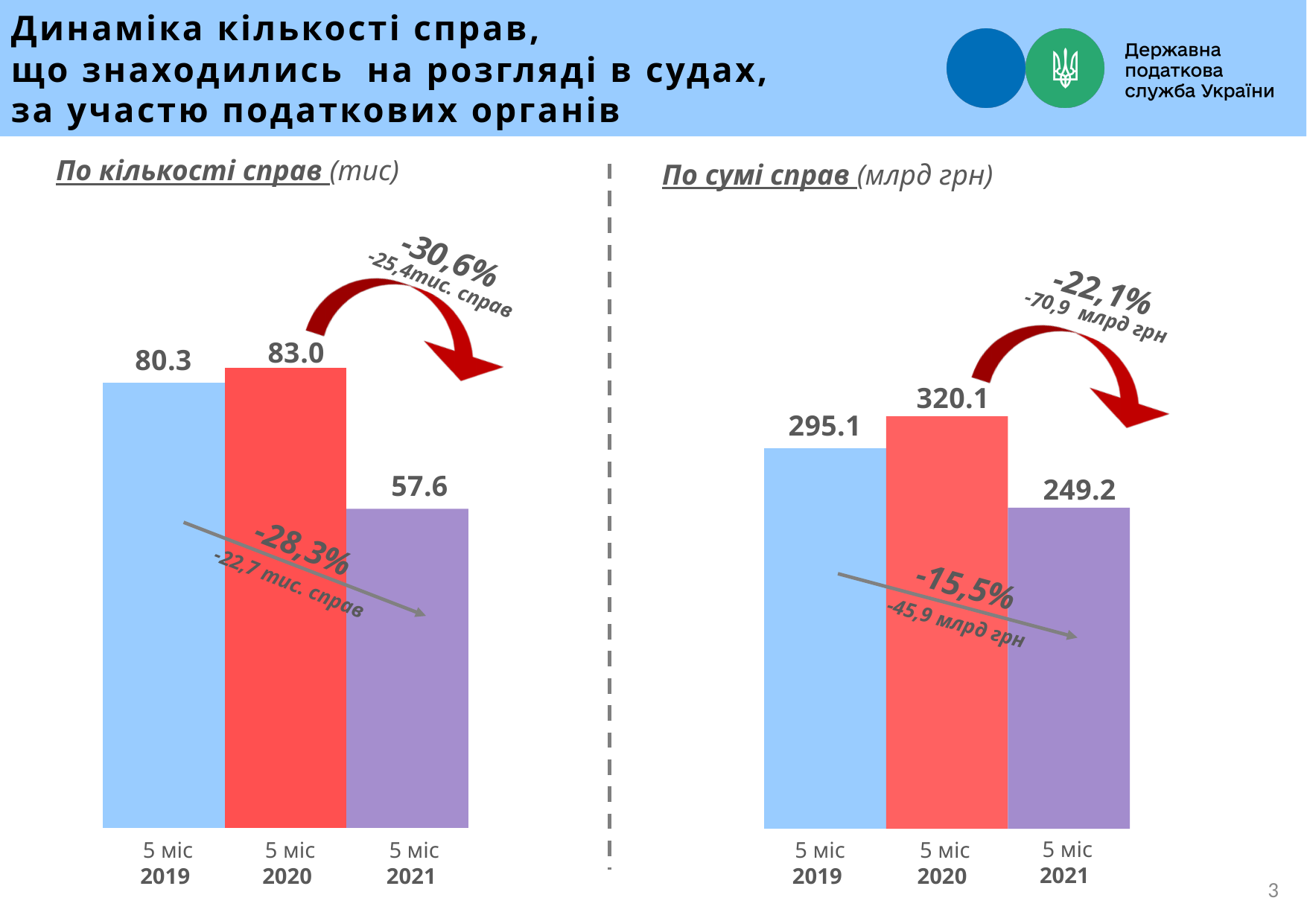
In the left chart (По кількості справ), which period has the highest value? 5 міс 2020 In the right chart (По сумі справ), what is the difference between the values for 5 міс 2020 and 5 міс 2021? 70.9 What type of chart is the right chart (По сумі справ)? Bar chart How many bars are shown in the left chart (По кількості справ)? 3 In the right chart (По сумі справ), what is the value for 5 міс 2021? 249.2 In the right chart (По сумі справ), which period has the lowest value? 5 міс 2021 In the right chart (По сумі справ), which is larger: the value for 5 міс 2019 or 5 міс 2020? 5 міс 2020 In the left chart (По кількості справ), what is the value for 5 міс 2021? 57.6 In the left chart (По кількості справ), what is the value for 5 міс 2020? 83.0 In the right chart (По сумі справ), what is the value for 5 міс 2019? 295.1 What unit is given in the title of the right chart (По сумі справ)? млрд грн In the left chart (По кількості справ), what is the difference between the values for 5 міс 2020 and 5 міс 2021? 25.4